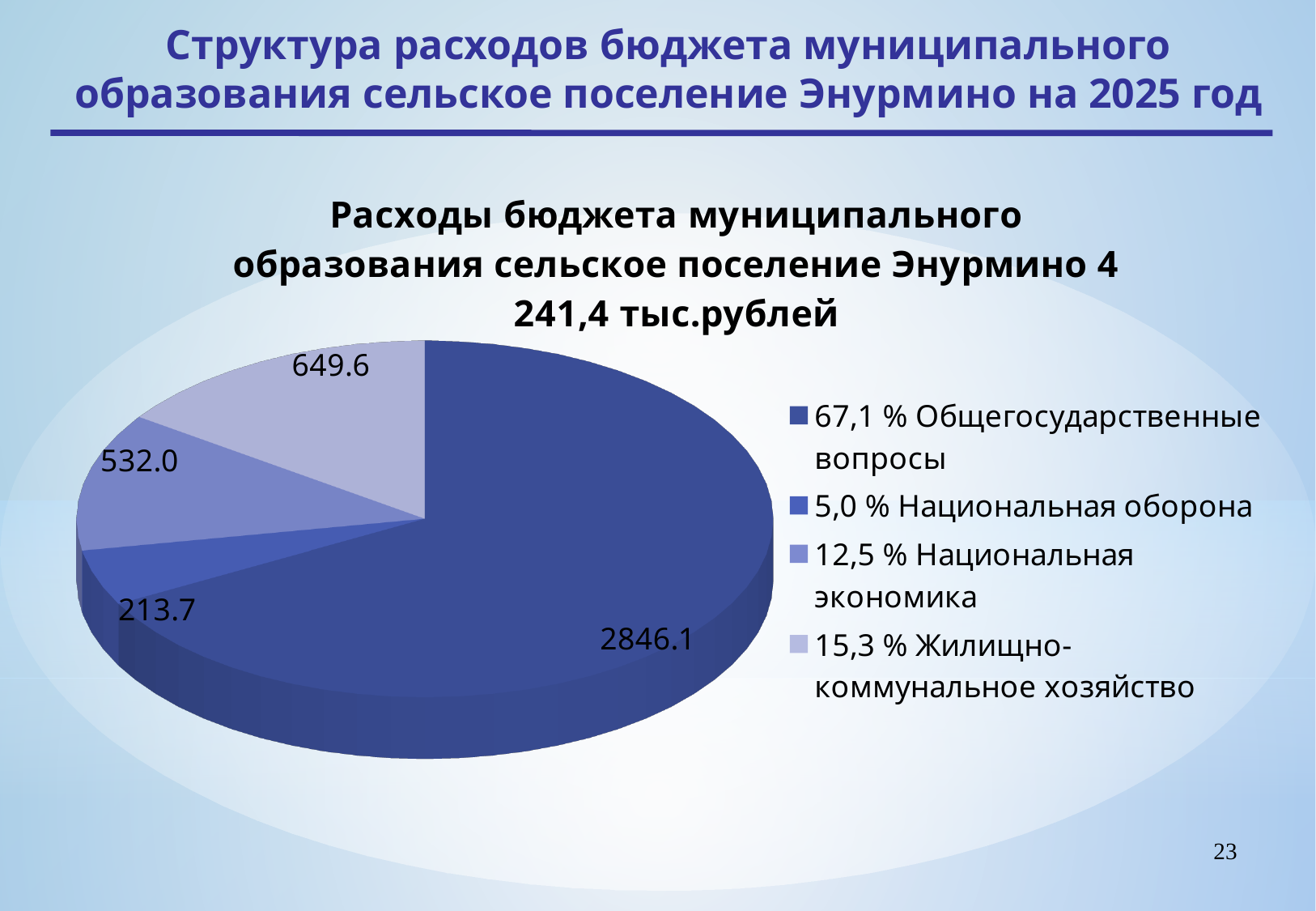
What is the value for Жилищно-коммунальное хозяйство? 649.6 Which is larger: the value for Национальная экономика or the value for Жилищно-коммунальное хозяйство? Жилищно-коммунальное хозяйство What is the value for Национальная экономика? 532.0 What share of the pie does Национальная экономика represent, according to the legend? 12,5 % Which category has the smallest slice of the pie? Национальная оборона What kind of chart is shown on the slide? pie chart What is the difference between the values for Жилищно-коммунальное хозяйство and Национальная экономика? 117.6 Which category has the largest slice of the pie? Общегосударственные вопросы What is the value for Национальная оборона? 213.7 How many slices does the pie chart have? 4 What is the value for Общегосударственные вопросы? 2846.1 What share of the pie does Жилищно-коммунальное хозяйство represent, according to the legend? 15,3 %